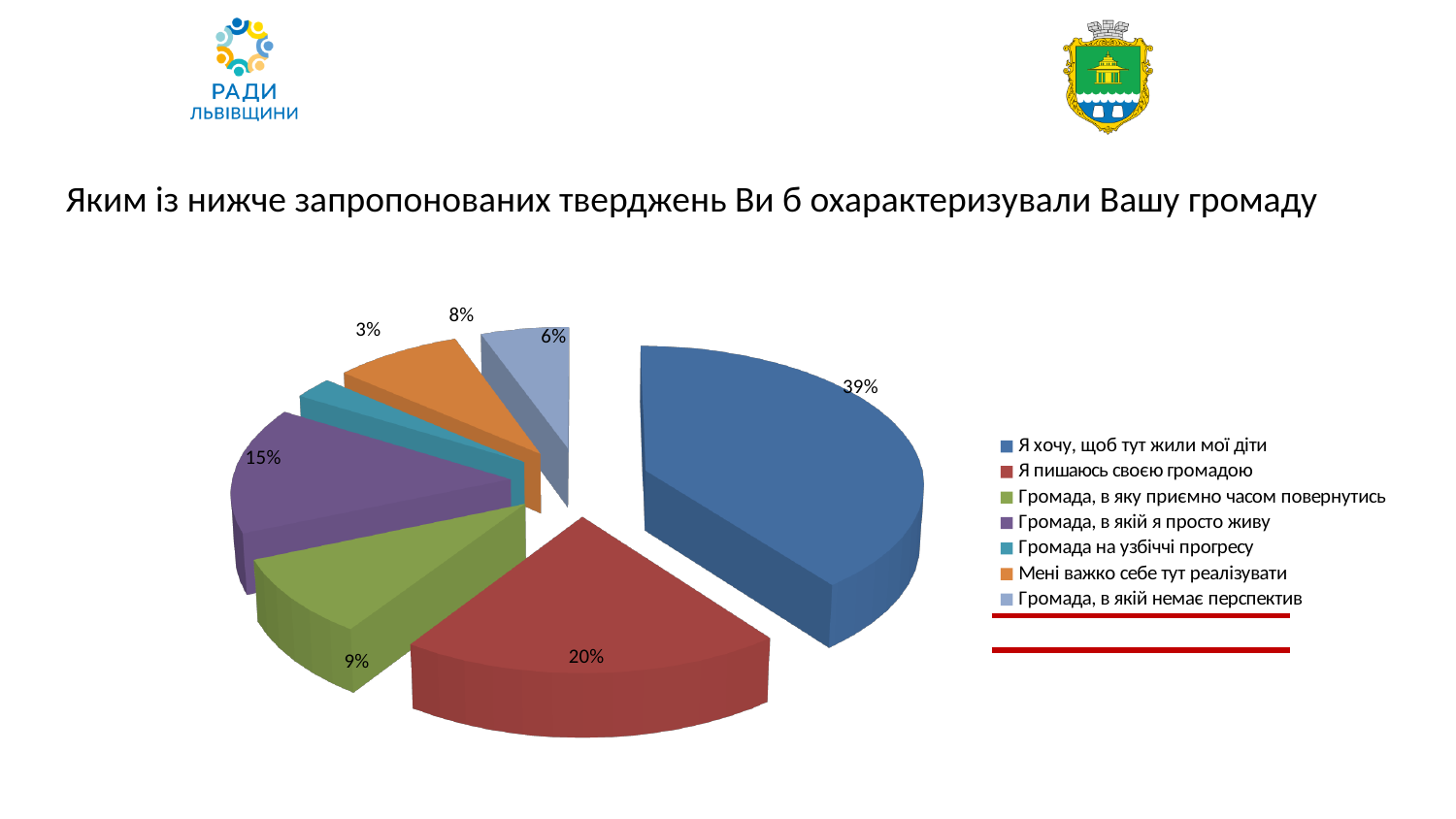
What colour is the slice for "Мені важко себе тут реалізувати"? Orange What is the value shown for "Я пишаюсь своєю громадою"? 20% Which category has the smallest slice of the pie? Громада на узбіччі прогресу What is the value shown for "Громада, в якій немає перспектив"? 6% What is the value shown for "Громада, в якій я просто живу"? 15% Which category has the largest slice of the pie? Я хочу, щоб тут жили мої діти What is the value shown for "Громада на узбіччі прогресу"? 3% Which is larger: the share for "Громада, в яку приємно часом повернутись" or for "Мені важко себе тут реалізувати"? Громада, в яку приємно часом повернутись What share of the pie does "Я хочу, щоб тут жили мої діти" have? 39% What is the difference between the shares for "Я хочу, щоб тут жили мої діти" and "Я пишаюсь своєю громадою"? 19% How many categories does the legend list? 7 What kind of chart is shown on the slide? Pie chart